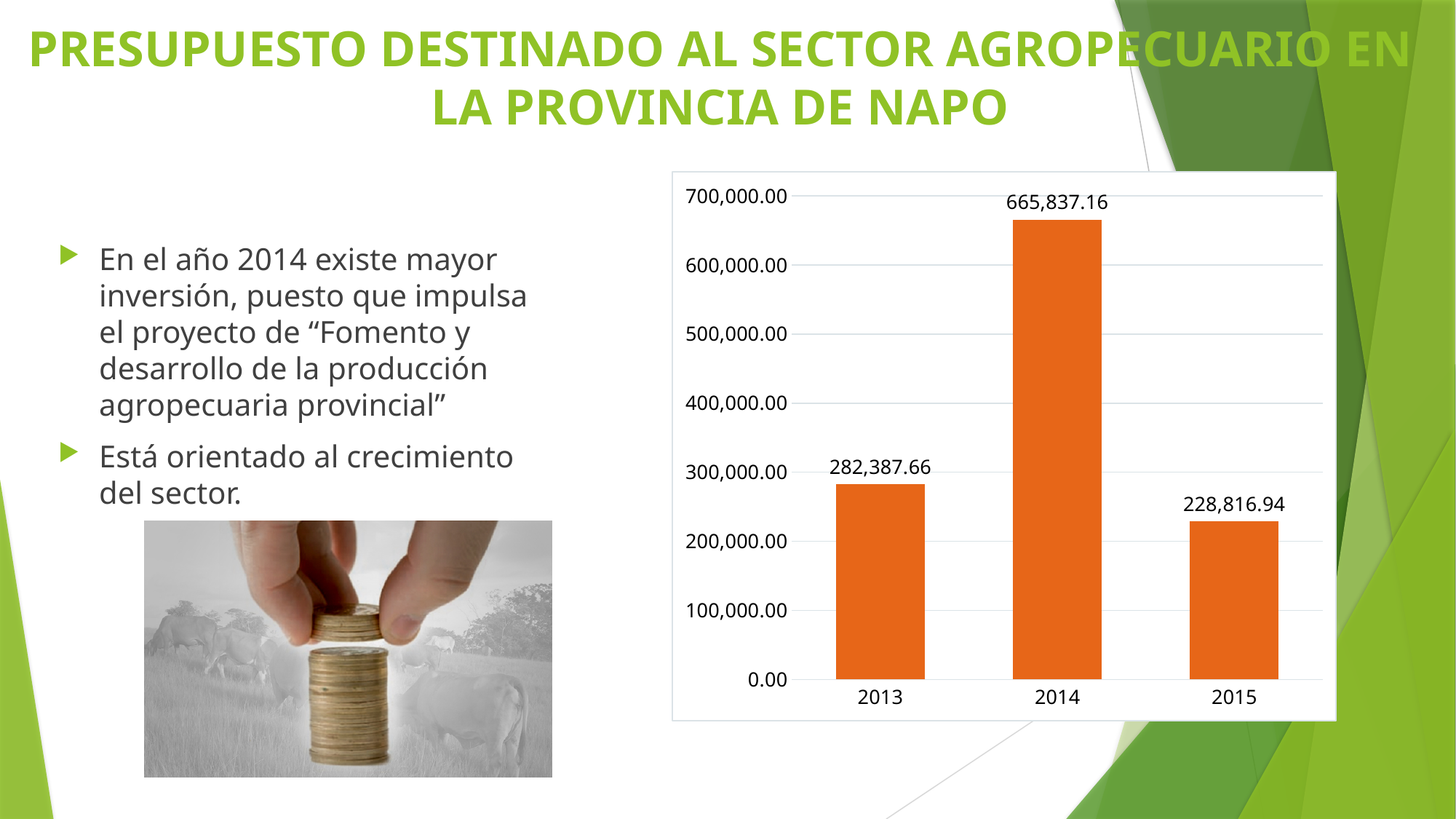
Is the value for 2014 greater or less than 600,000.00? greater Which year has the highest value? 2014 What is the value shown for 2015? 228,816.94 How many years are shown on the x axis? 3 What kind of chart is shown on the slide? Bar chart What is the difference between the values for 2013 and 2015? 53,570.72 Which year has the lowest value? 2015 What is the difference between the values for 2014 and 2013? 383,449.50 Which is larger, the value for 2013 or the value for 2015? 2013 What is the value shown for 2013? 282,387.66 What colour are the bars in the chart? Orange What is the value shown for 2014? 665,837.16